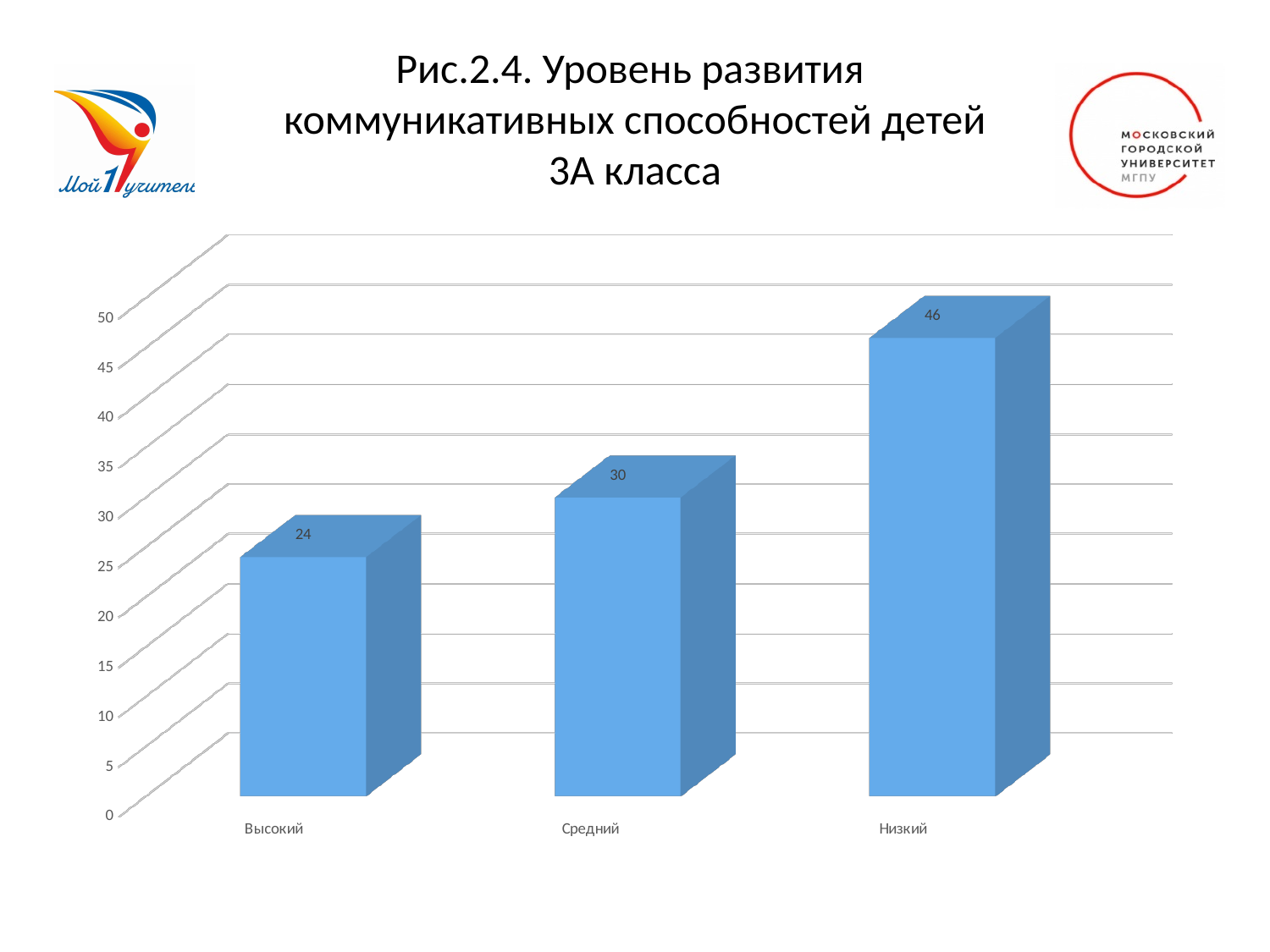
What is the value for Средний? 30 How many categories are shown on the x axis? 3 What is the value for Низкий? 46 What is the difference between the values for Средний and Высокий? 6 Which category has the lowest value? Высокий What is the value for Высокий? 24 Which category has the highest value? Низкий Is the value for Низкий greater or less than 40? greater What kind of chart is shown on the slide? bar chart What is the difference between the values for Низкий and Высокий? 22 Do the values rise or fall from left to right along the x axis? rise Which is larger, the value for Средний or the value for Низкий? Низкий